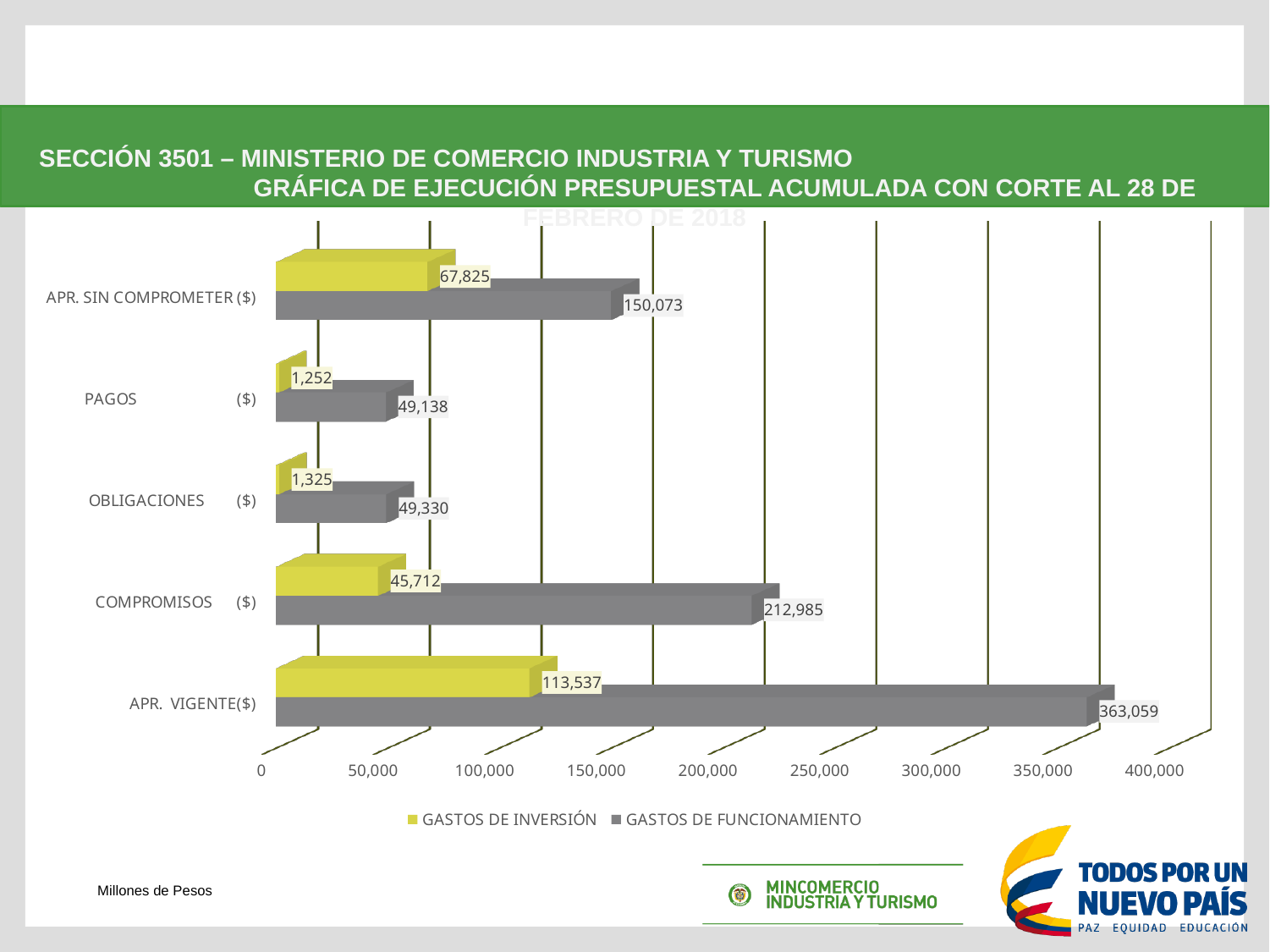
What is the value of GASTOS DE INVERSIÓN for APR. SIN COMPROMETER ($)? 67,825 How many categories are shown on the chart? 5 What is the value of GASTOS DE FUNCIONAMIENTO for APR. VIGENTE($)? 363,059 What is the value of GASTOS DE FUNCIONAMIENTO for PAGOS ($)? 49,138 What is the value of GASTOS DE INVERSIÓN for COMPROMISOS ($)? 45,712 Which category has the highest GASTOS DE FUNCIONAMIENTO value? APR. VIGENTE($) Which is larger: GASTOS DE INVERSIÓN for APR. SIN COMPROMETER ($) or GASTOS DE FUNCIONAMIENTO for OBLIGACIONES ($)? GASTOS DE INVERSIÓN for APR. SIN COMPROMETER ($) What kind of chart is shown on the slide? Bar chart What is the difference between GASTOS DE FUNCIONAMIENTO and GASTOS DE INVERSIÓN for COMPROMISOS ($)? 167,273 How many series does the legend list? 2 Which category has the lowest GASTOS DE INVERSIÓN value? PAGOS ($) Is the GASTOS DE FUNCIONAMIENTO value for COMPROMISOS ($) greater or less than 200,000? greater